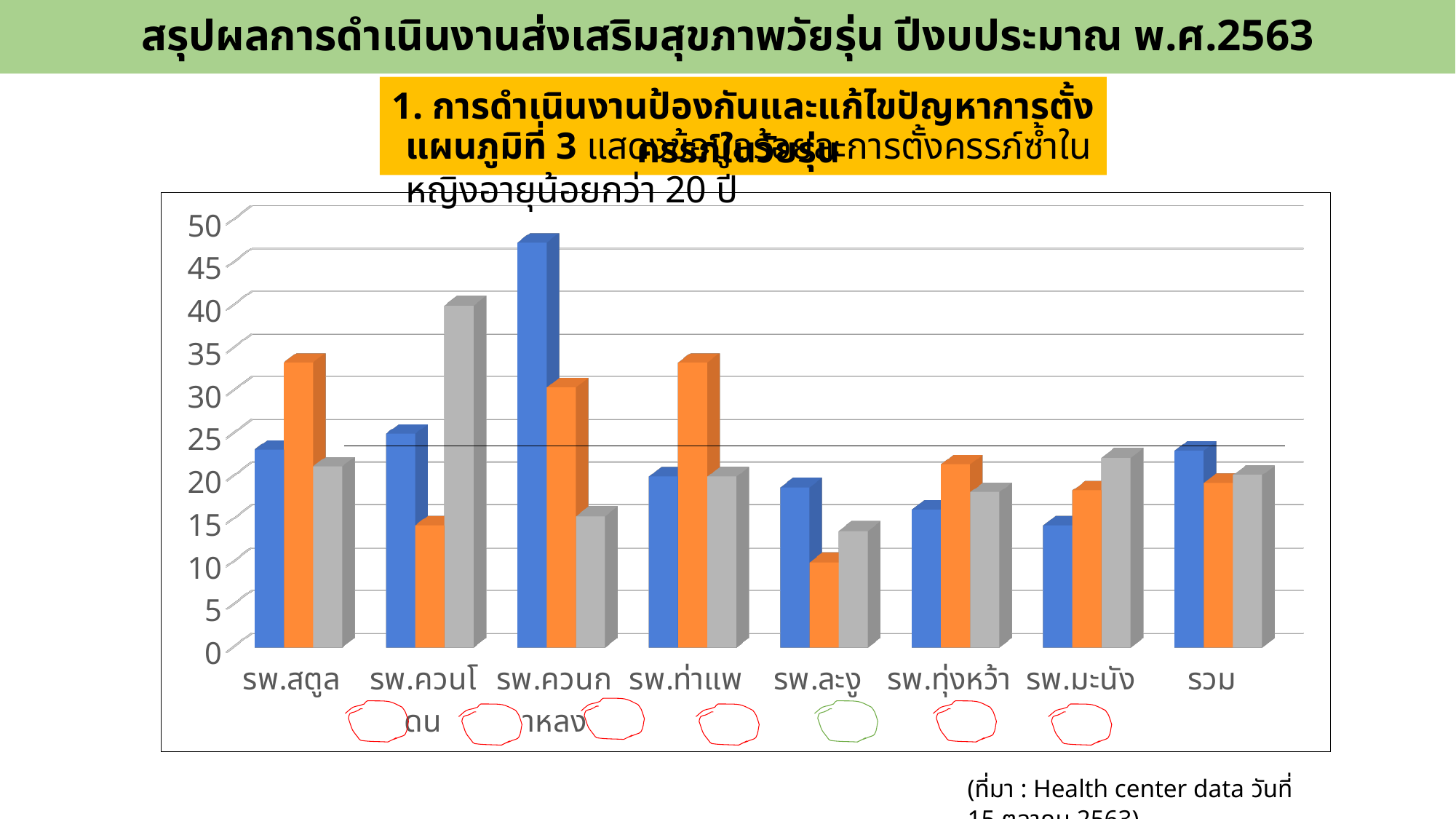
For รพ.ท่าแพ, which is larger: the orange bar or the blue bar? the orange bar Is the value of the orange bar for รพ.สตูล greater or less than 30? greater Among the gray bars, which category has the lowest value? รพ.ละงู Among the gray bars, which category has the highest value? รพ.ควนโดน What kind of chart is shown on the slide? bar chart Is the value of the orange bar for รพ.ละงู greater or less than 15? less Is the value of the blue bar for รพ.ละงู greater or less than 20? less How many categories are shown along the x axis of the chart? 8 For รพ.ควนโดน, which is larger: the gray bar or the orange bar? the gray bar Among the blue bars, which category has the lowest value? รพ.มะนัง Which category has the tallest bar in the chart? รพ.ควนกาหลง